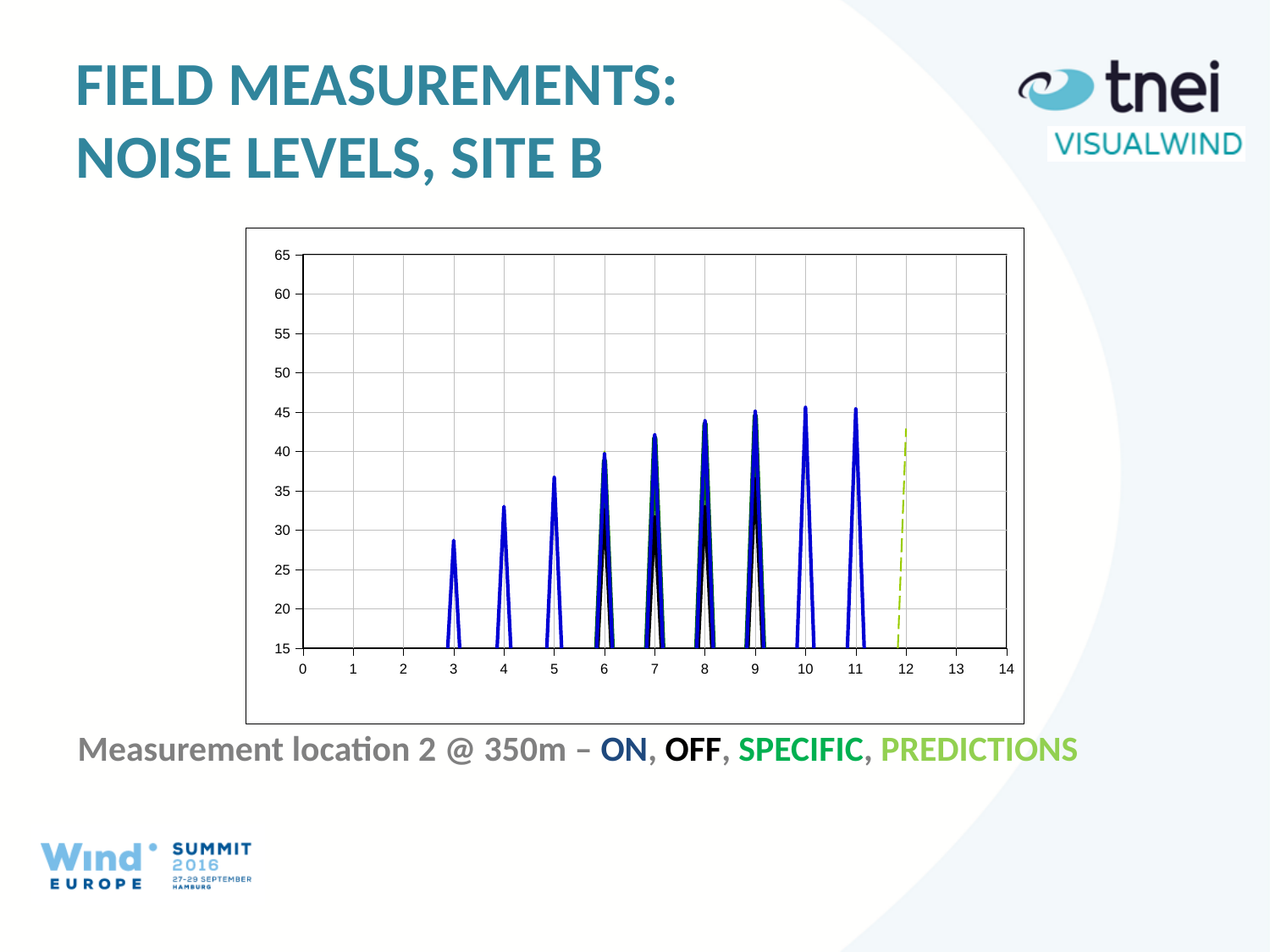
At how many x-axis positions does the blue ON series show a peak? 9 What colour is the ON series in the chart? blue Is the peak of the blue ON series at x = 3 greater or less than 30? less At which x-axis value is the lowest peak of the blue ON series? 3 Is the peak of the blue ON series at x = 10 greater or less than 45? greater Do the peaks of the blue ON series rise or fall from x = 3 to x = 10? rise What kind of chart is shown on the slide? line chart What is the range of the y axis on the chart? 15 to 65 Is the peak of the blue ON series at x = 8 greater or less than 45? less Which peak of the blue ON series is higher, the one at x = 3 or the one at x = 4? x = 4 How many series does the caption below the chart list (ON, OFF, SPECIFIC, PREDICTIONS)? 4